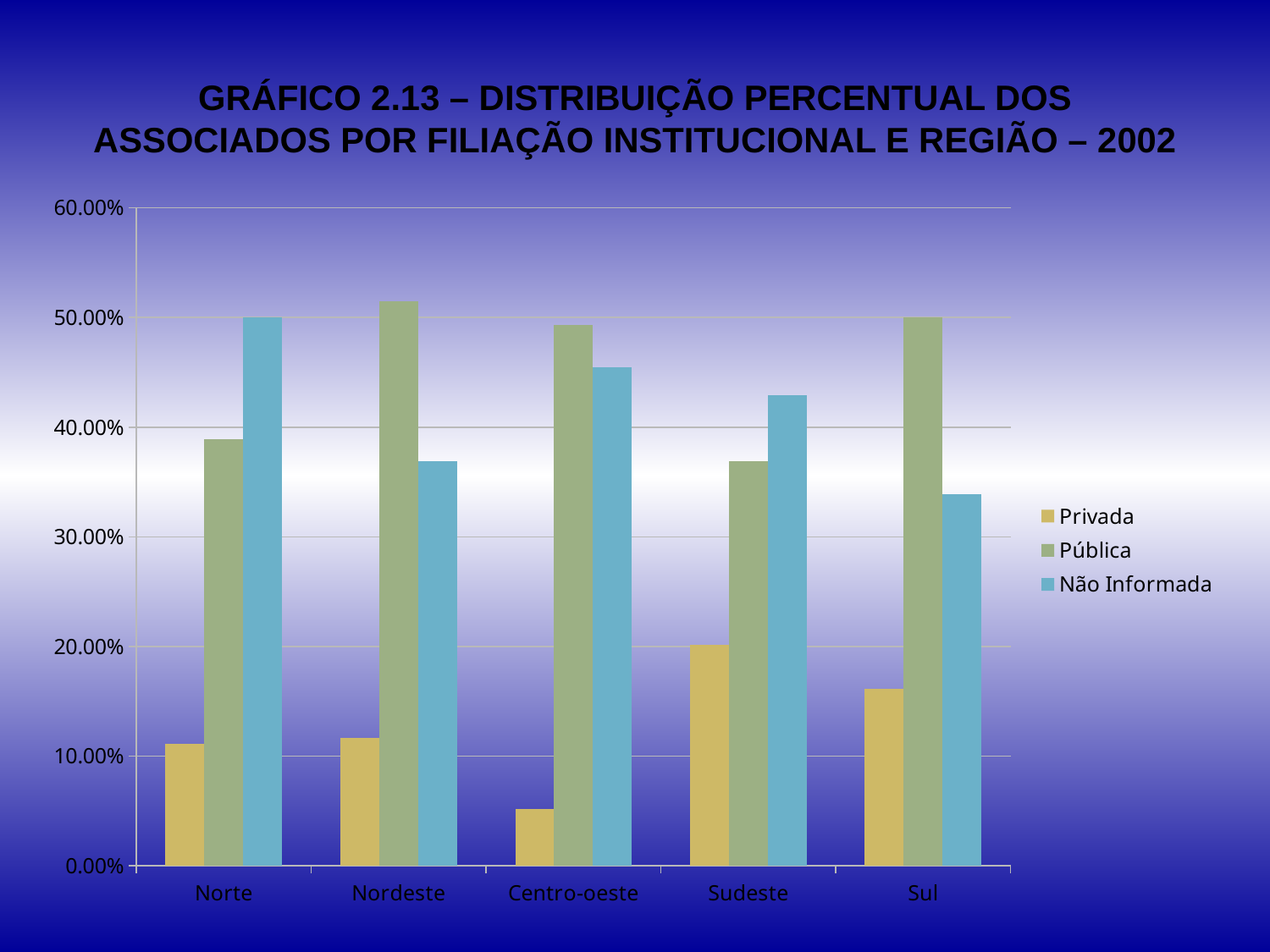
What kind of chart is shown on the slide? bar chart Which region has the highest value for Privada? Sudeste Which region has the lowest value for Privada? Centro-oeste Is the value for Pública in Norte greater or less than 40.00%? less Which region has the lowest value for Não Informada? Sul How many series does the legend list? 3 In Norte, which is larger: Pública or Não Informada? Não Informada Which region has the highest value for Não Informada? Norte Is the value for Não Informada in Centro-oeste greater or less than 40.00%? greater What are the three series listed in the legend? Privada, Pública, Não Informada How many regions are shown on the x axis of the chart? 5 In Sul, which is larger: Pública or Não Informada? Pública